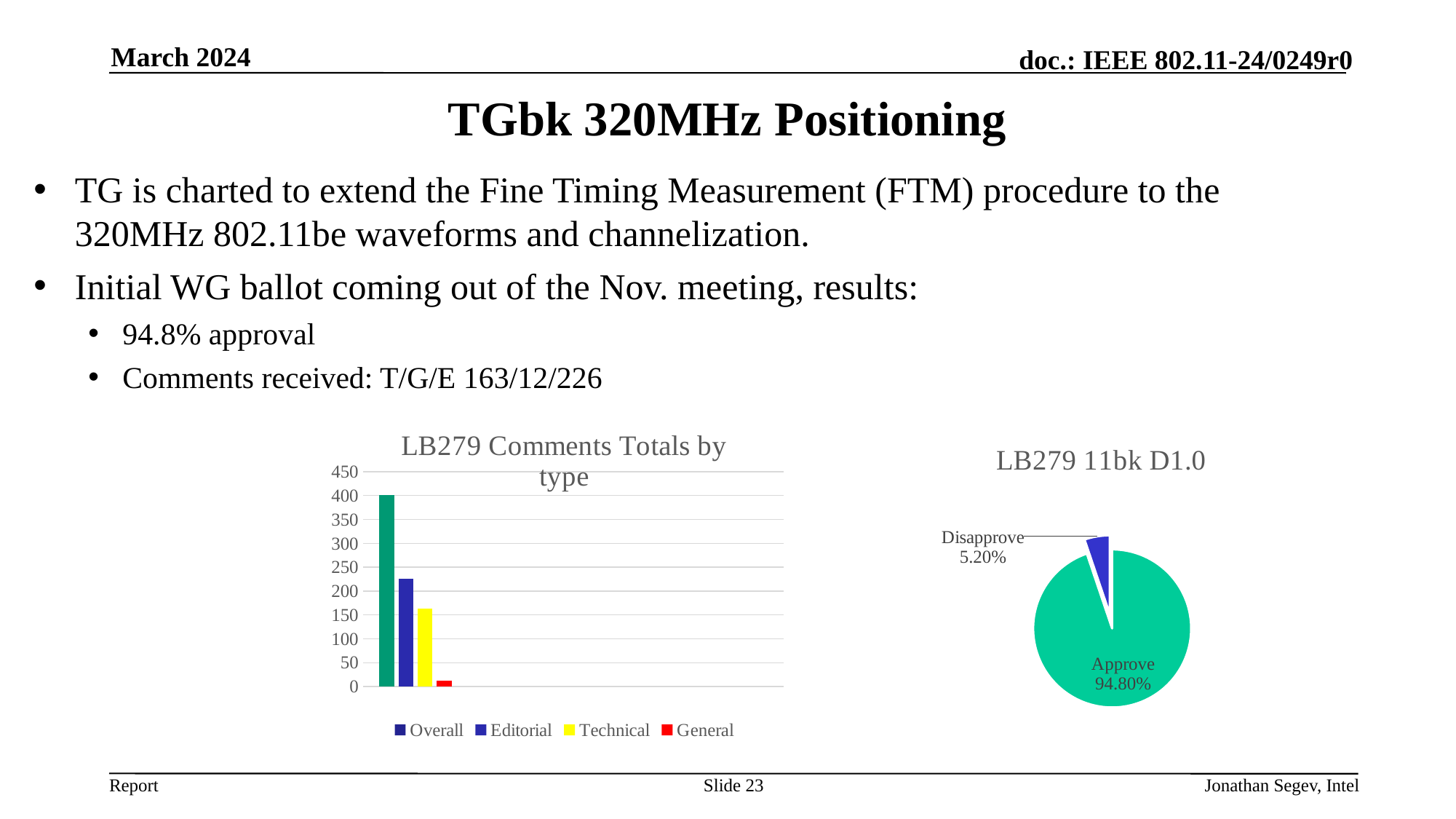
In the 'LB279 Comments Totals by type' chart, is the value for General greater or less than 50? less In the 'LB279 Comments Totals by type' chart, is the value for Technical greater or less than 200? less What kind of chart is the one titled 'LB279 11bk D1.0'? pie chart In the 'LB279 Comments Totals by type' chart, is the value for Overall greater or less than 350? greater In the 'LB279 Comments Totals by type' chart, which series has the shortest bar? General In the 'LB279 11bk D1.0' pie chart, what share is labelled for Disapprove? 5.20% In the 'LB279 Comments Totals by type' chart, which is larger, Editorial or Technical? Editorial In the 'LB279 Comments Totals by type' chart, which series has the tallest bar? Overall In the 'LB279 11bk D1.0' pie chart, what share is labelled for Approve? 94.80% In the 'LB279 Comments Totals by type' chart, how many series does the legend list? 4 What kind of chart is the one titled 'LB279 Comments Totals by type'? bar chart